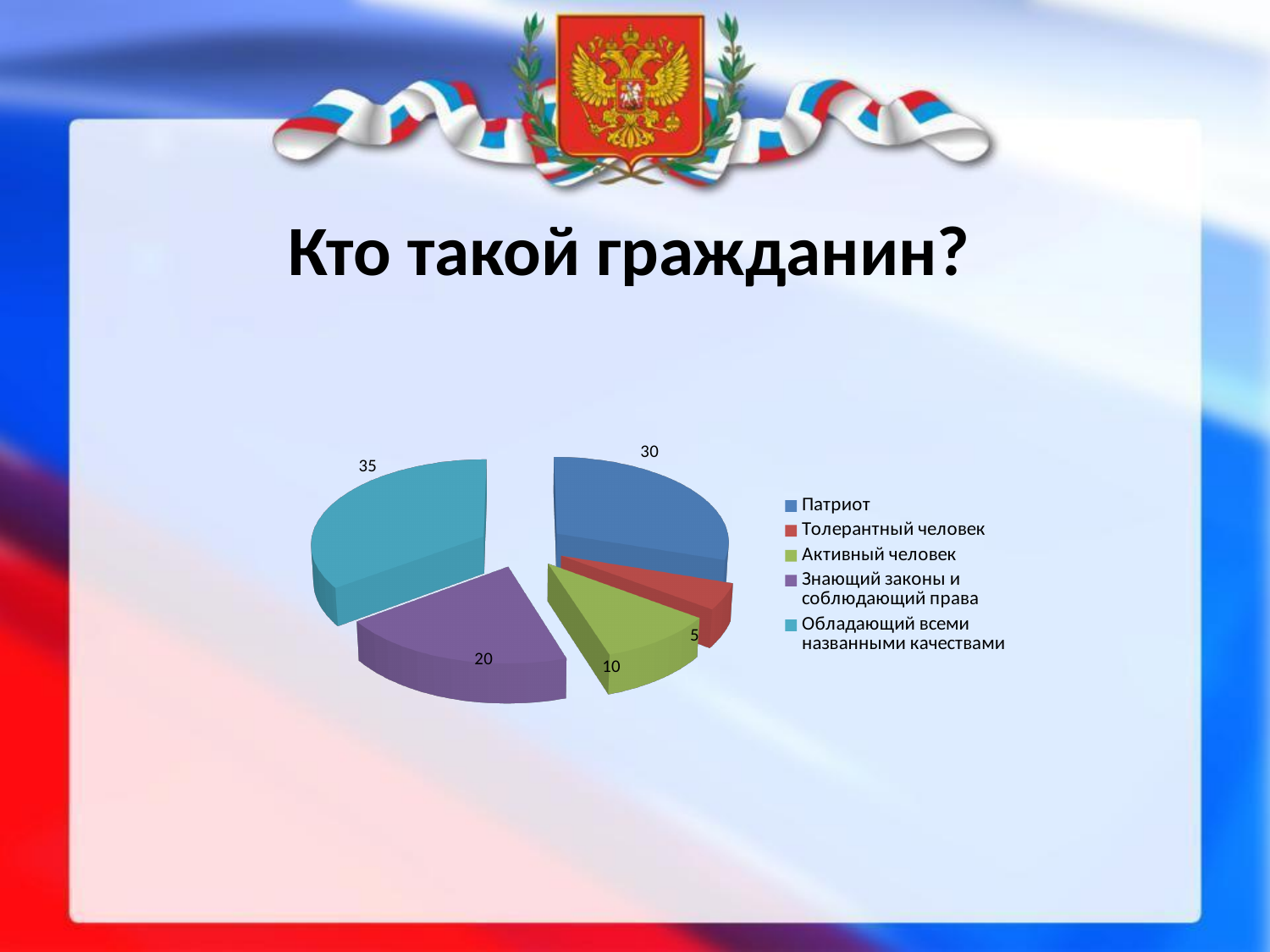
Which is larger, the value for Активный человек or the value for Знающий законы и соблюдающий права? Знающий законы и соблюдающий права What is the value for Обладающий всеми названными качествами? 35 What kind of chart is shown on the slide? Pie chart What is the value for Патриот? 30 How many categories does the pie chart have? 5 Which category has the smallest slice? Толерантный человек What share of the pie does the Патриот slice represent? 30% What is the value for Активный человек? 10 Which category has the largest slice? Обладающий всеми названными качествами What is the difference between the values for Обладающий всеми названными качествами and Патриот? 5 What is the value for Знающий законы и соблюдающий права? 20 What is the value for Толерантный человек? 5